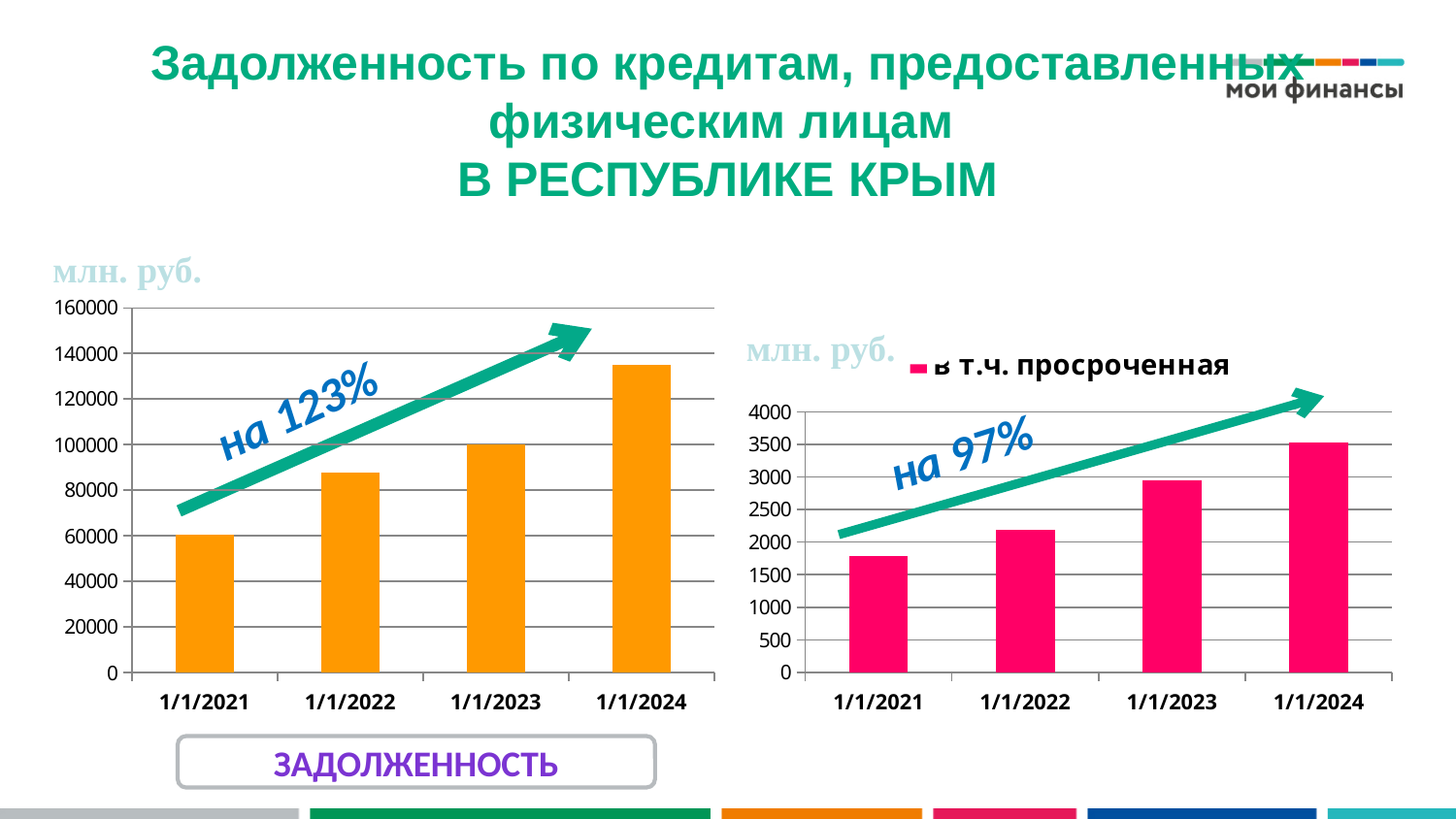
In the left chart (ЗАДОЛЖЕННОСТЬ), which date has the highest value? 1/1/2024 In the right chart (в т.ч. просроченная), is the value for 1/1/2021 greater or less than 2000? less In the right chart (в т.ч. просроченная), is the value for 1/1/2023 greater or less than 2500? greater In the right chart (в т.ч. просроченная), which is larger, the value for 1/1/2022 or 1/1/2023? 1/1/2023 In the left chart (ЗАДОЛЖЕННОСТЬ), is the value for 1/1/2022 greater or less than 80000? greater In the left chart (ЗАДОЛЖЕННОСТЬ), which date has the lowest value? 1/1/2021 What percentage growth is annotated on the right chart (в т.ч. просроченная)? на 97% In the right chart (в т.ч. просроченная), which date has the highest value? 1/1/2024 In the left chart (ЗАДОЛЖЕННОСТЬ), do the values rise or fall from 1/1/2021 to 1/1/2024? rise In the left chart (ЗАДОЛЖЕННОСТЬ), how many dates are shown on the x axis? 4 What type of chart is the left chart labelled ЗАДОЛЖЕННОСТЬ? bar chart